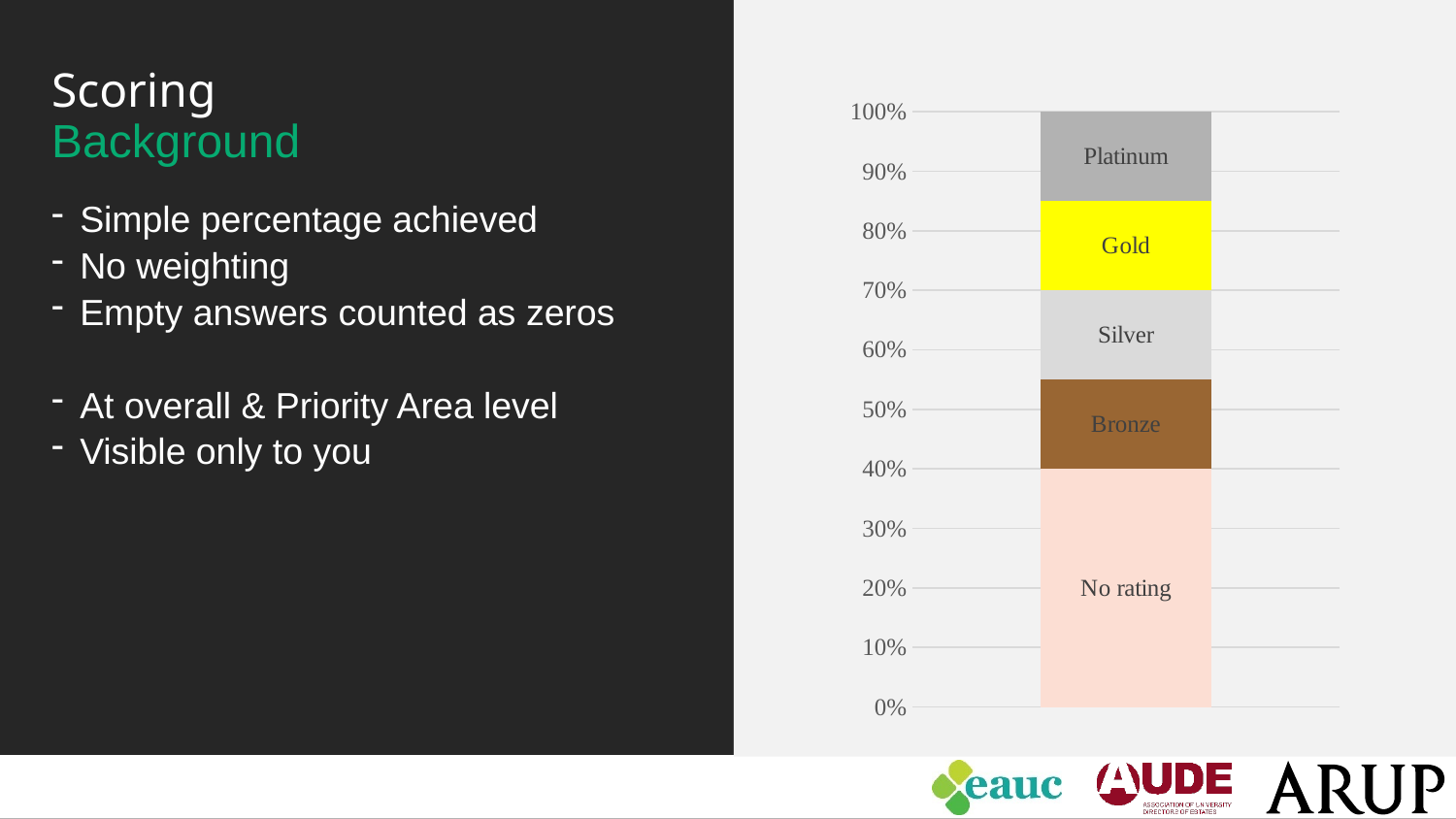
At what percentage on the axis does the "Silver" segment end and the "Gold" segment begin? 70% Is the top of the "Bronze" segment greater or less than 50%? greater Is the top of the "Gold" segment greater or less than 80%? greater At what percentage on the axis does the top of the "Platinum" segment sit? 100% Which segment of the stacked bar is the largest? No rating Which segment is larger, "No rating" or "Bronze"? No rating Which segment of the stacked bar is coloured yellow? Gold Which segment is at the top of the stacked bar? Platinum Is the top of the "Silver" segment greater or less than 60%? greater How many segments make up the stacked bar? 5 What kind of chart is shown on the slide? stacked bar chart At what percentage on the axis does the "No rating" segment end and the "Bronze" segment begin? 40%